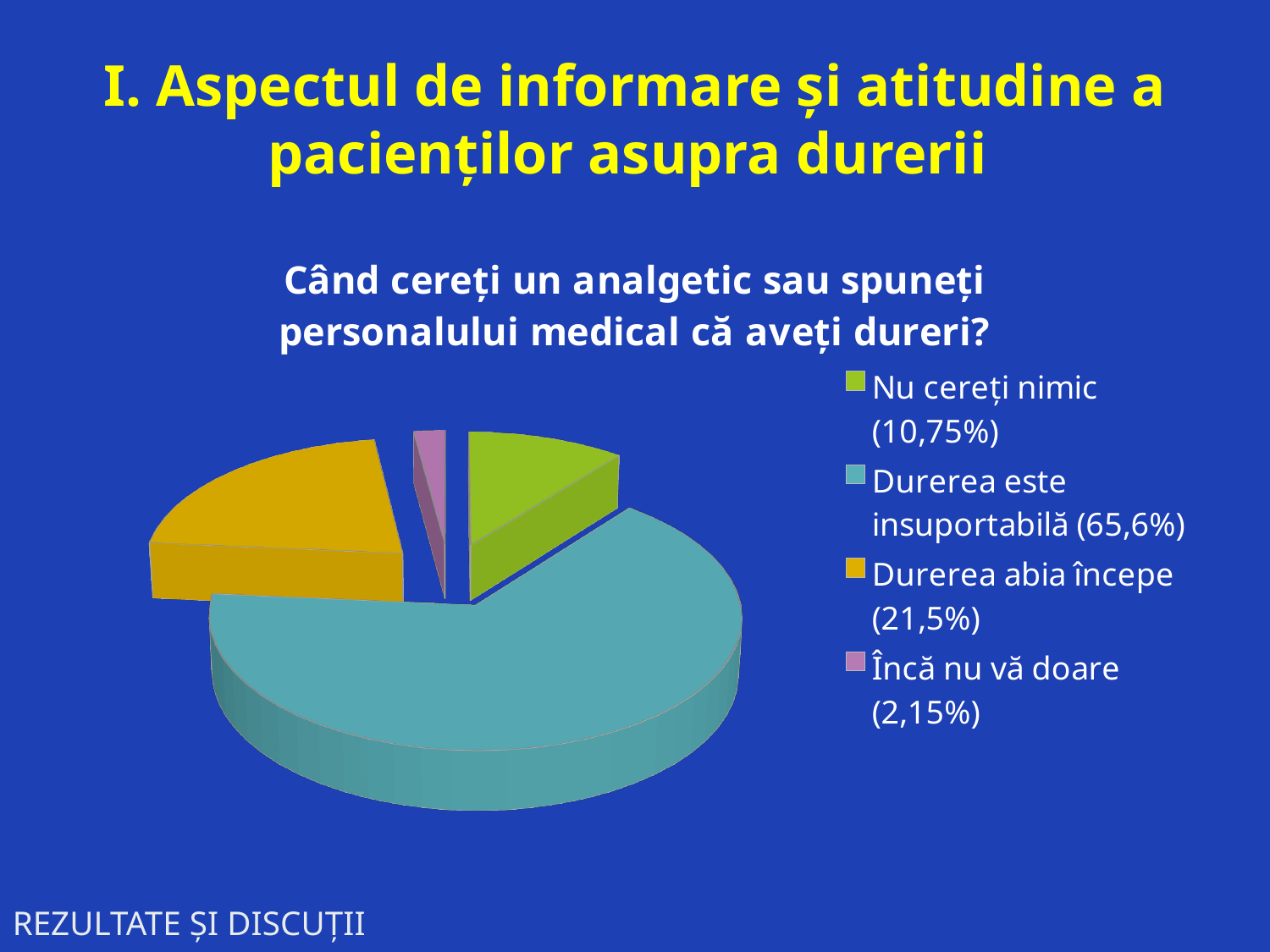
What is the chart's title? Când cereți un analgetic sau spuneți personalului medical că aveți dureri? Which is larger: 'Durerea abia începe' or 'Nu cereți nimic'? Durerea abia începe Which category has the smallest slice of the pie? Încă nu vă doare What share of the pie is 'Încă nu vă doare'? 2,15% How many slices does the pie chart have? 4 What is the difference in percentage points between 'Durerea este insuportabilă' and 'Durerea abia începe'? 44,1% What kind of chart is shown on the slide? Pie chart What share of the pie is 'Nu cereți nimic'? 10,75% Which category has the largest slice of the pie? Durerea este insuportabilă What share of the pie is 'Durerea este insuportabilă'? 65,6% What colour is the slice for 'Durerea abia începe'? Yellow/orange